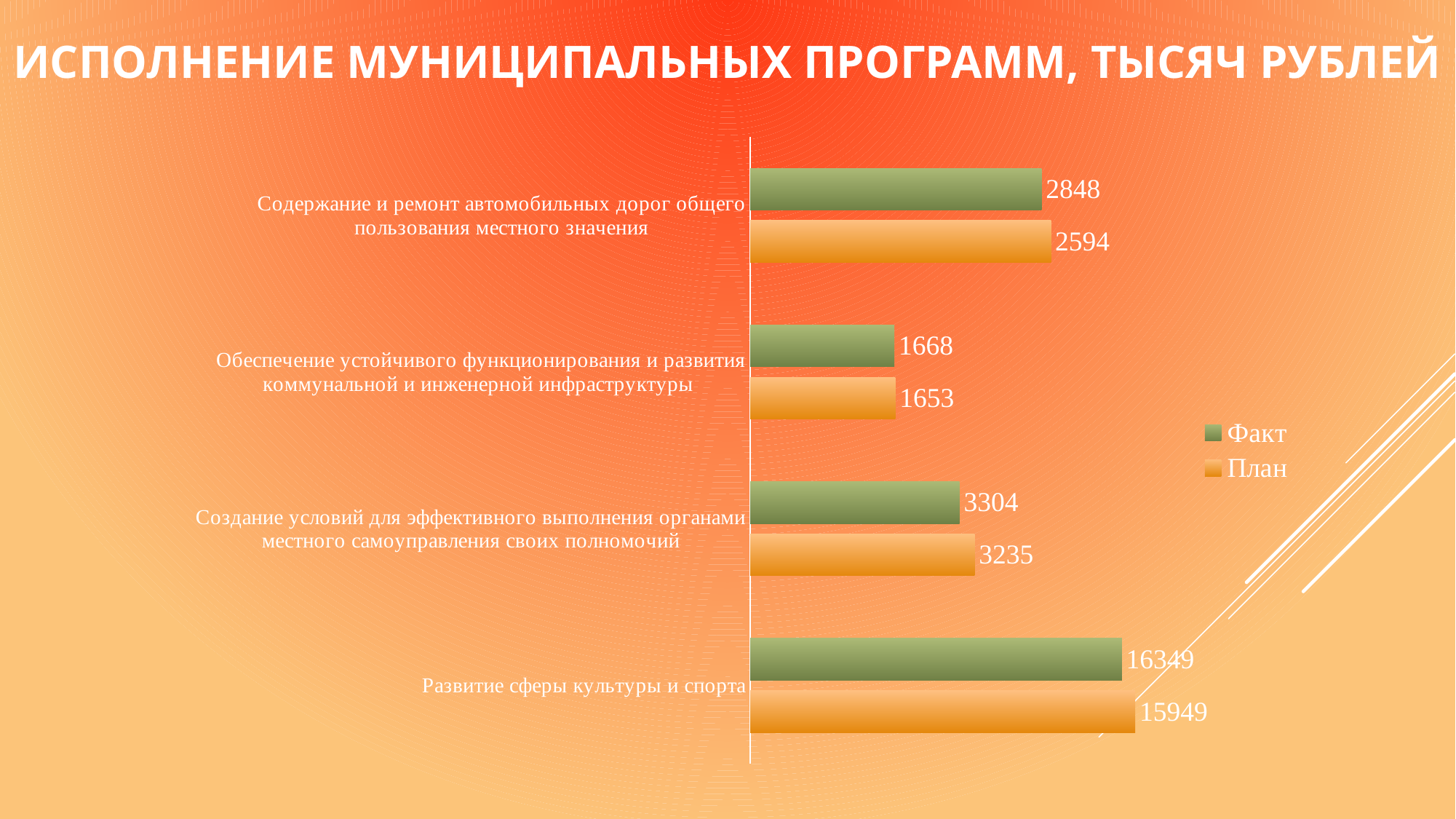
How many series does the legend list? 2 What is the План value for Создание условий для эффективного выполнения органами местного самоуправления своих полномочий? 3235 Which category has the highest Факт value? Развитие сферы культуры и спорта What is the План value for Содержание и ремонт автомобильных дорог общего пользования местного значения? 2594 What is the Факт value for Обеспечение устойчивого функционирования и развития коммунальной и инженерной инфраструктуры? 1668 What is the Факт value for Развитие сферы культуры и спорта? 16349 How many categories are shown in the chart? 4 What kind of chart is shown on the slide? Bar chart For Создание условий для эффективного выполнения органами местного самоуправления своих полномочий, which is larger, Факт or План? Факт Which category has the lowest План value? Обеспечение устойчивого функционирования и развития коммунальной и инженерной инфраструктуры What is the difference between the Факт and План values for Содержание и ремонт автомобильных дорог общего пользования местного значения? 254 What is the difference between the Факт and План values for Развитие сферы культуры и спорта? 400